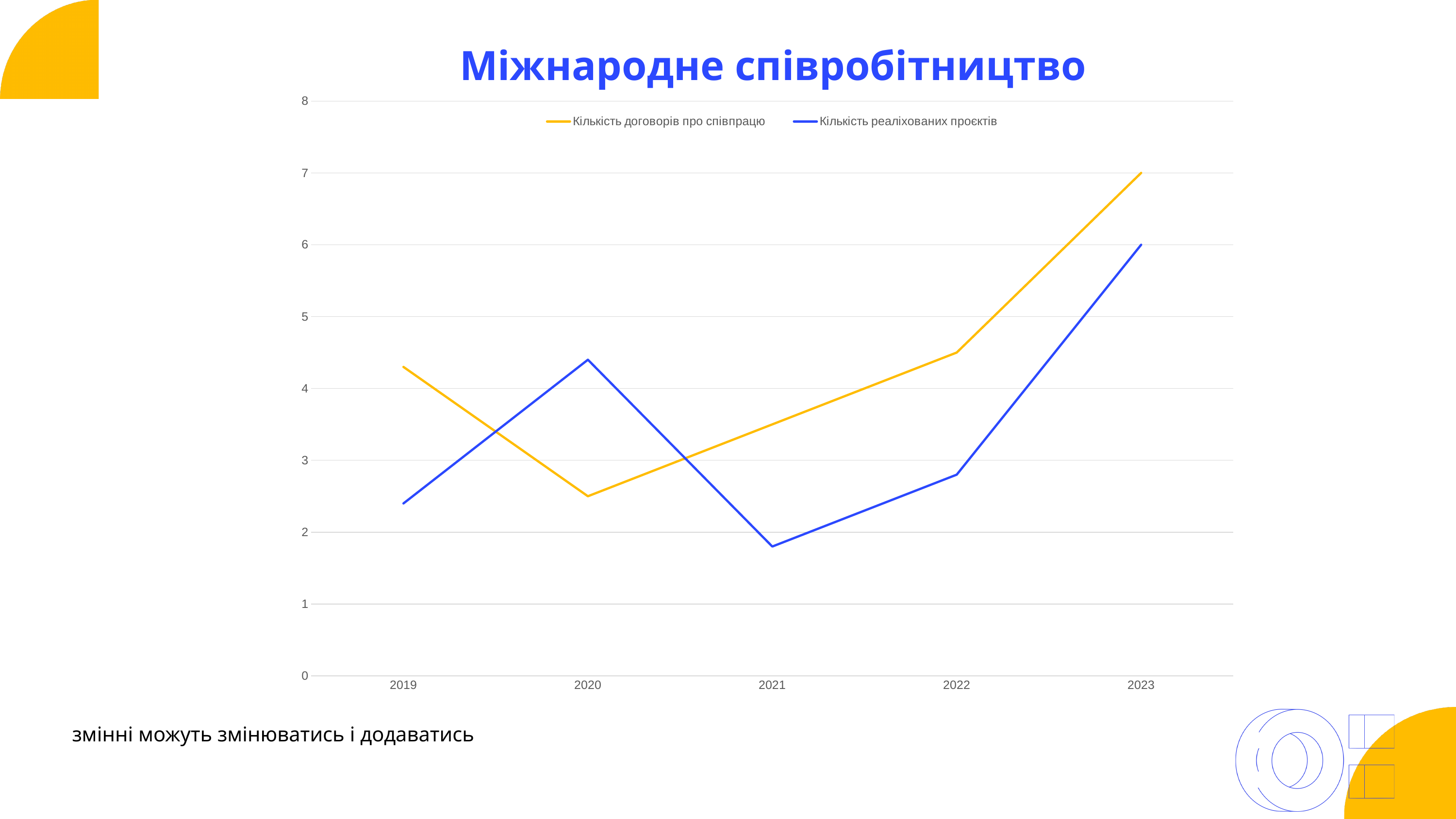
In which year is "Кількість договорів про співпрацю" lowest? 2020 In 2023, what is the difference between "Кількість договорів про співпрацю" and "Кількість реаліхованих проєктів"? 1 Is the value for "Кількість реаліхованих проєктів" in 2021 greater or less than 2? less How many years are shown on the x axis? 5 In which year is "Кількість реаліхованих проєктів" highest? 2023 What is the title of the chart? Міжнародне співробітництво How many series does the legend list? 2 What is the value of "Кількість договорів про співпрацю" in 2023? 7 In which year is "Кількість реаліхованих проєктів" lowest? 2021 In 2020, which series has the larger value: "Кількість договорів про співпрацю" or "Кількість реаліхованих проєктів"? Кількість реаліхованих проєктів What is the value of "Кількість реаліхованих проєктів" in 2023? 6 What kind of chart is shown on the slide? line chart